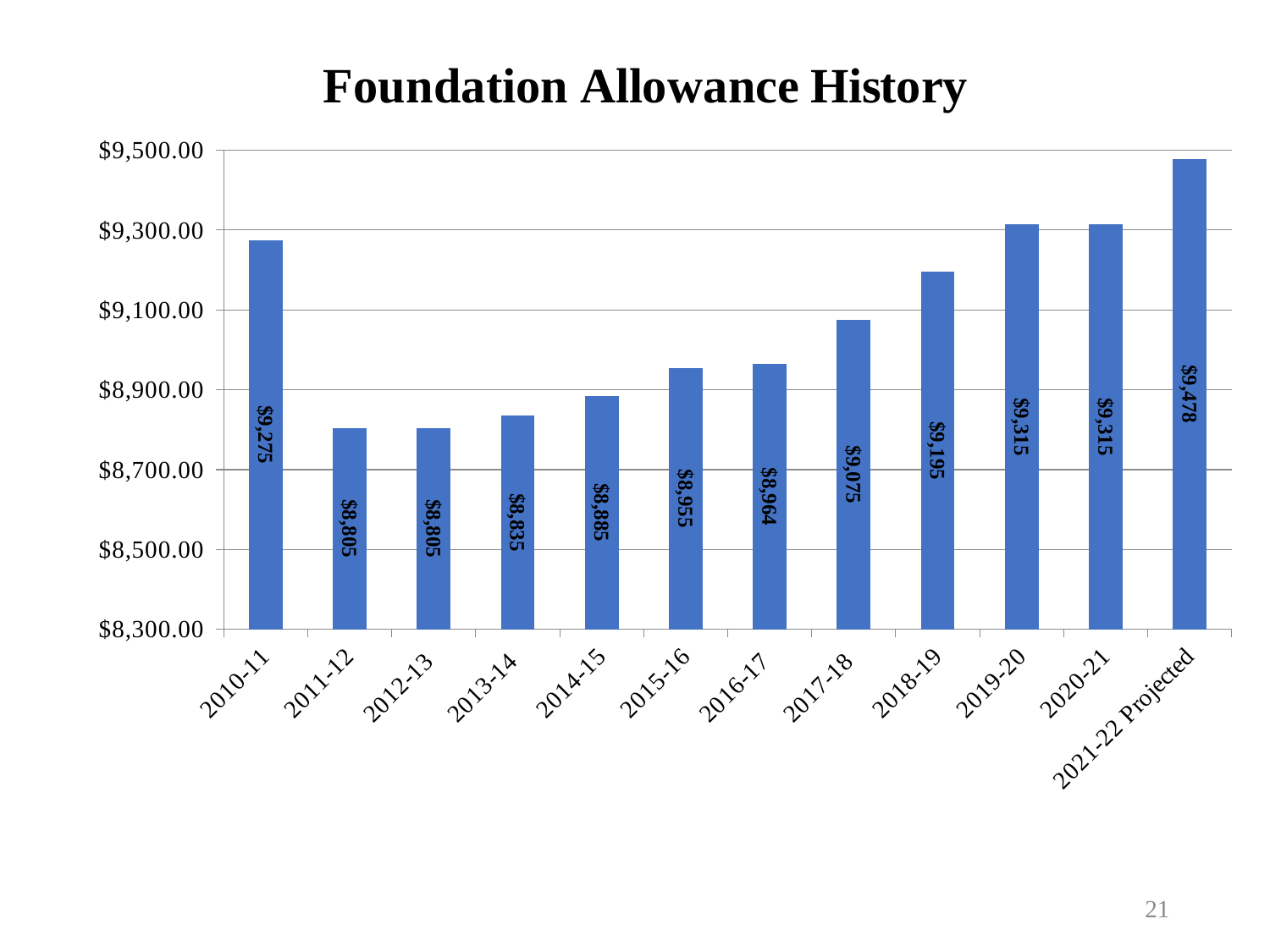
What is the foundation allowance for 2010-11? $9,275 What is the difference between the foundation allowance in 2010-11 and 2011-12? $470 What is the difference between the foundation allowance in 2021-22 Projected and 2020-21? $163 Is the foundation allowance for 2017-18 greater or less than $9,100.00? less Which year has the highest foundation allowance? 2021-22 Projected How many years are shown on the chart? 12 Which years have the lowest foundation allowance? 2011-12 and 2012-13 What kind of chart is shown on the slide? bar chart What is the foundation allowance for 2016-17? $8,964 What is the projected foundation allowance for 2021-22? $9,478 Which is larger, the foundation allowance for 2010-11 or for 2018-19? 2010-11 What is the title of the chart? Foundation Allowance History